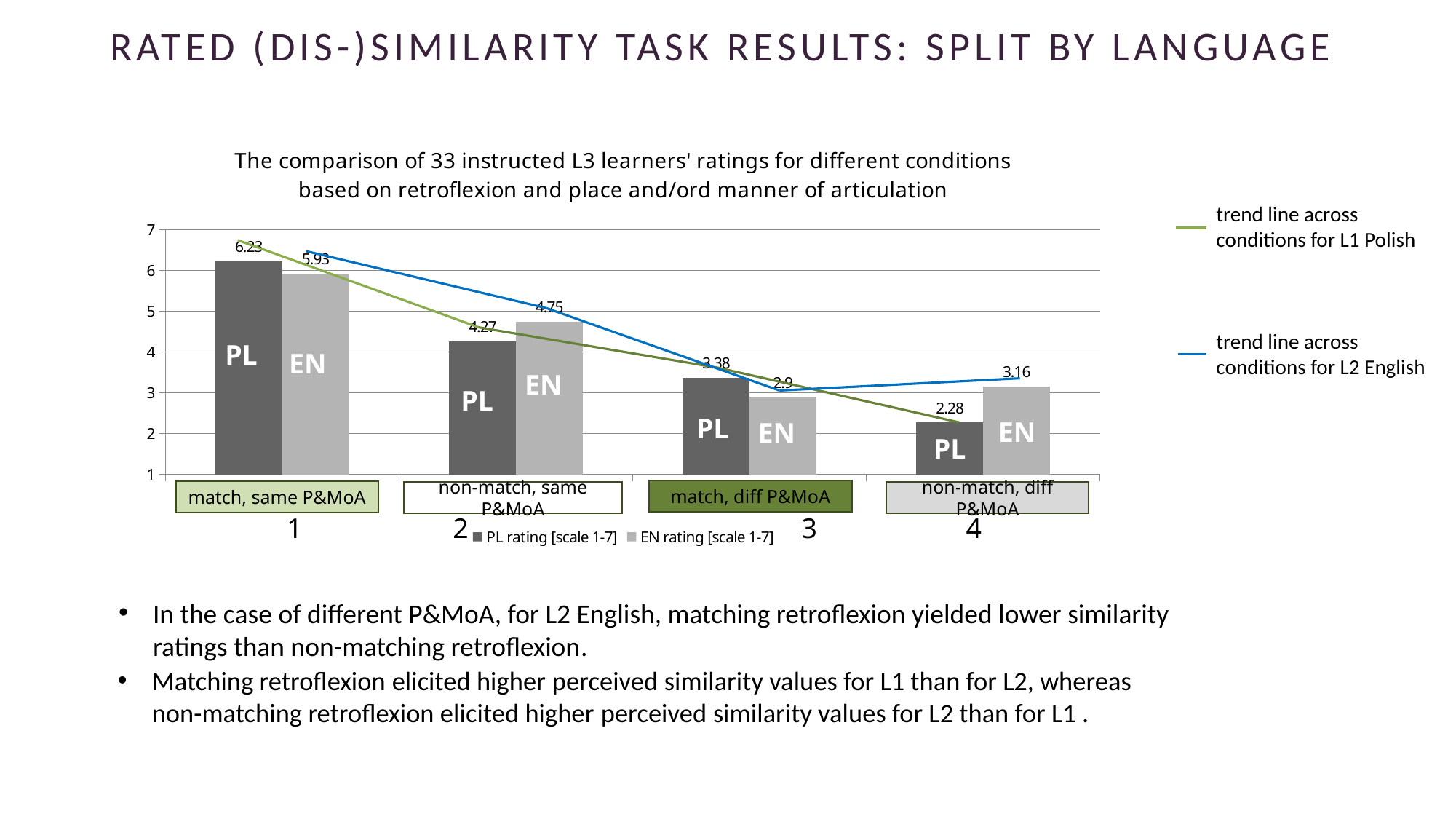
What is the difference between the PL rating and the EN rating for the 'match, same P&MoA' condition? 0.3 Is the PL rating for the 'non-match, same P&MoA' condition greater or less than 4? greater What is the PL rating for the 'match, same P&MoA' condition? 6.23 How many conditions are shown on the x axis of the chart? 4 What is the PL rating for the 'non-match, diff P&MoA' condition? 2.28 For the 'non-match, diff P&MoA' condition, which is larger: the PL rating or the EN rating? EN rating What is the EN rating for the 'match, diff P&MoA' condition? 2.9 What is the EN rating for the 'non-match, same P&MoA' condition? 4.75 Which condition has the highest PL rating? match, same P&MoA Do the PL ratings rise or fall from condition 1 to condition 4? fall Which condition has the lowest EN rating? match, diff P&MoA How many series does the chart's bar legend list? 2